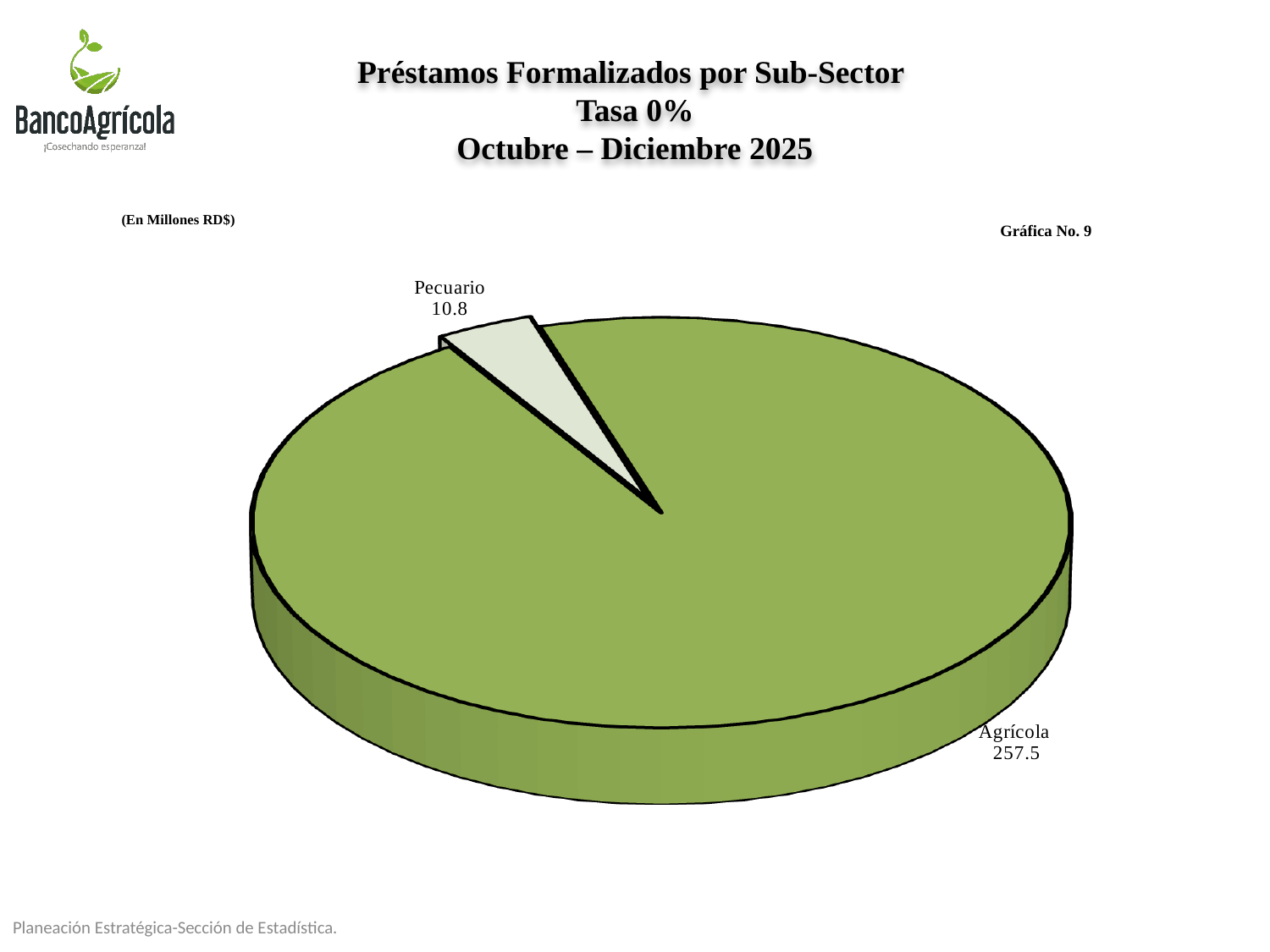
What is the difference between the Agrícola and Pecuario values? 246.7 In what units are the values in the chart expressed? En Millones RD$ What share of the pie does Pecuario represent, to the nearest whole percent? 4% Which sub-sector has the smallest slice of the pie? Pecuario What is the value for Agrícola? 257.5 What period does the chart title cover? Octubre – Diciembre 2025 How many slices does the pie chart have? 2 What is the total of the two slices in the pie chart? 268.3 What type of chart is shown on the slide? Pie chart Which is larger, the value for Agrícola or the value for Pecuario? Agrícola Which sub-sector has the largest slice of the pie? Agrícola What is the value for Pecuario? 10.8